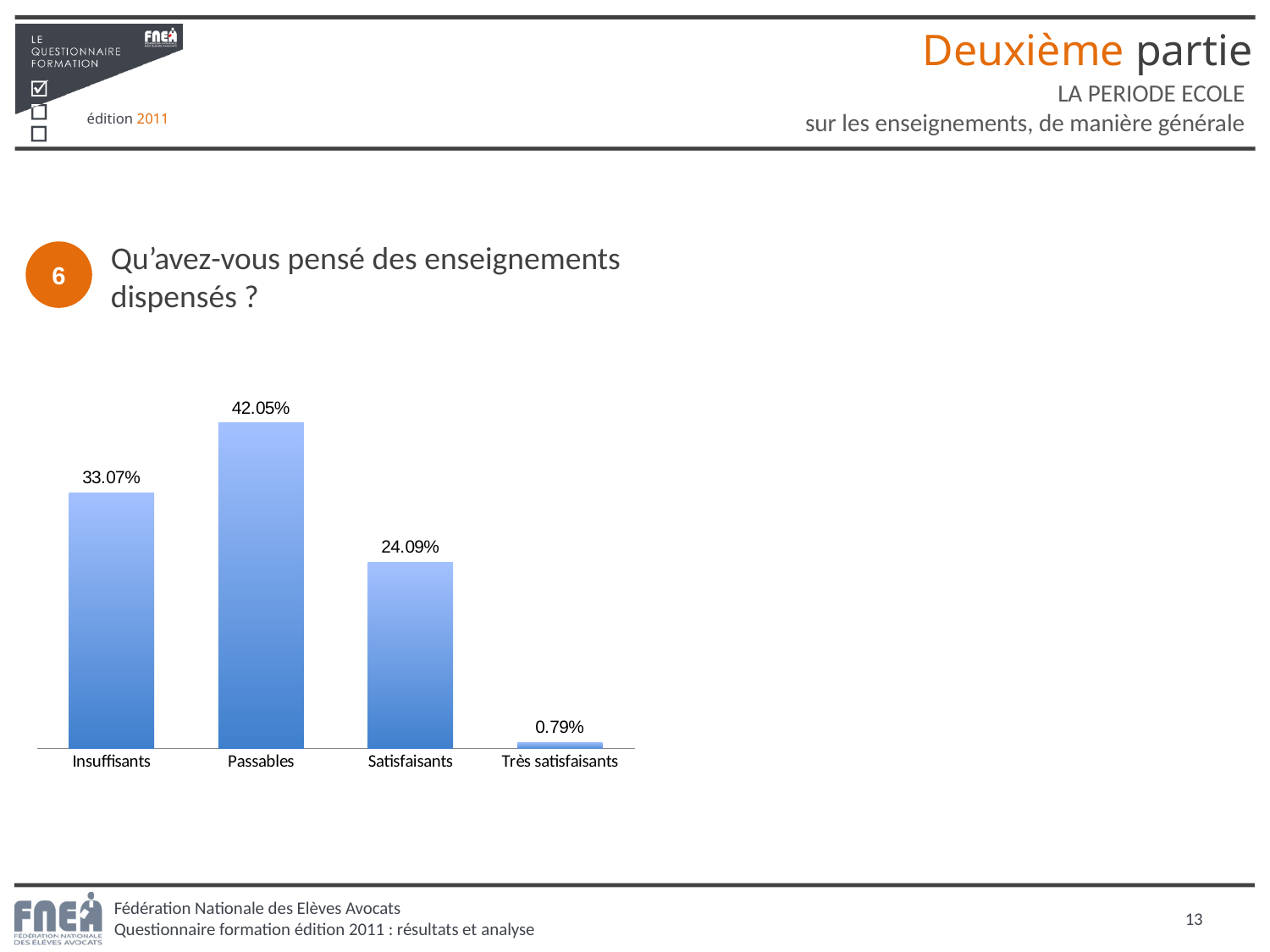
What is the difference between the values for Satisfaisants and Très satisfaisants? 23.30% Which category has the lowest value? Très satisfaisants Which is larger, the value for Insuffisants or the value for Satisfaisants? Insuffisants What is the value for Très satisfaisants? 0.79% What is the value for Satisfaisants? 24.09% Which category has the highest value? Passables What is the value for Insuffisants? 33.07% What is the difference between the values for Passables and Insuffisants? 8.98% What is the value for Passables? 42.05% How many categories are shown in the chart? 4 What kind of chart is shown on the slide? Bar chart What question does the chart answer, according to the slide? Qu'avez-vous pensé des enseignements dispensés ?